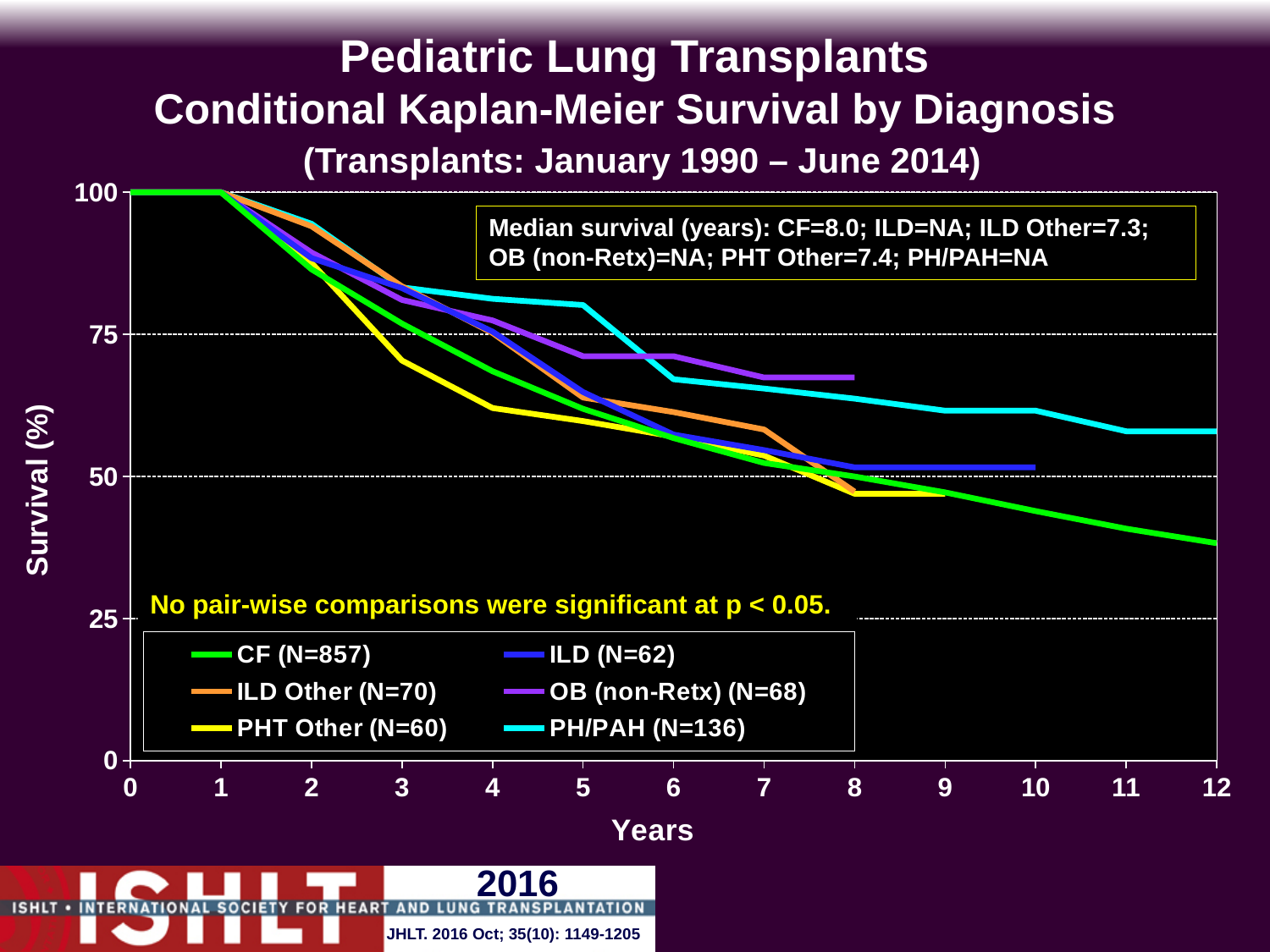
According to the legend, what is the N for the CF group? 857 Is the survival value for CF at 12 years greater or less than 50? less According to the legend, what is the N for the PH/PAH group? 136 At 5 years, which series has the highest survival? PH/PAH What kind of chart is shown on the slide? line chart Do the survival curves rise or fall as years increase along the x axis? fall Is the survival value for PHT Other at 4 years greater or less than 75? less What is the median survival in years for PHT Other as stated on the slide? 7.4 What is the median survival in years for ILD Other as stated on the slide? 7.3 How many series does the legend list? 6 Is the survival value for PH/PAH at 10 years greater or less than 50? greater What is the median survival in years for CF as stated on the slide? 8.0